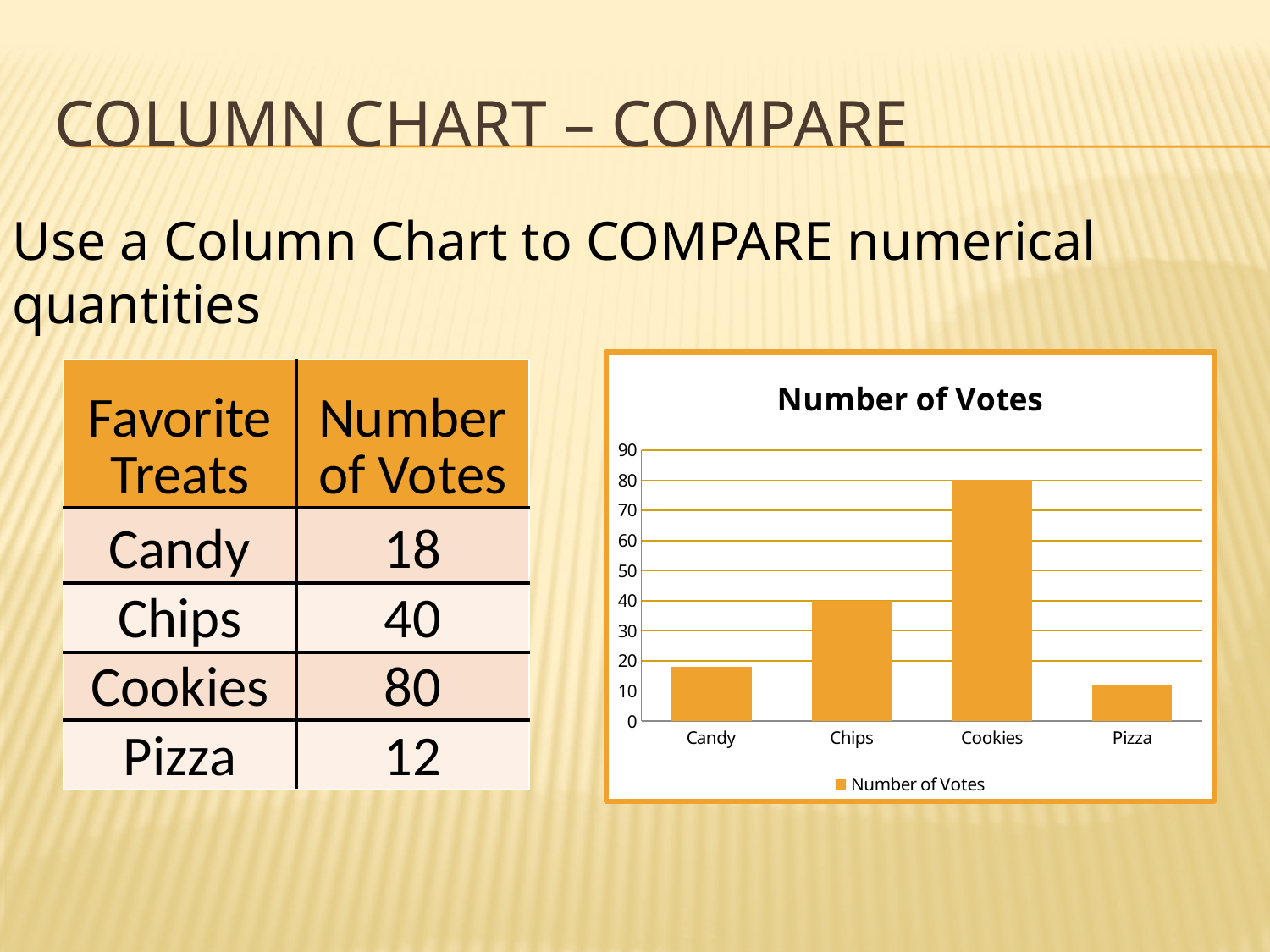
What is the difference in votes between Cookies and Chips? 40 What kind of chart is shown on the slide? bar chart How many votes did Cookies receive? 80 Which treat received the fewest votes? Pizza Which received more votes, Candy or Pizza? Candy How many series does the chart legend list? 1 How many votes did Candy receive? 18 Which treat received the most votes? Cookies How many votes did Chips receive? 40 Is the value for Candy greater or less than 20? less How many categories are plotted in the chart? 4 What is the title of the chart? Number of Votes